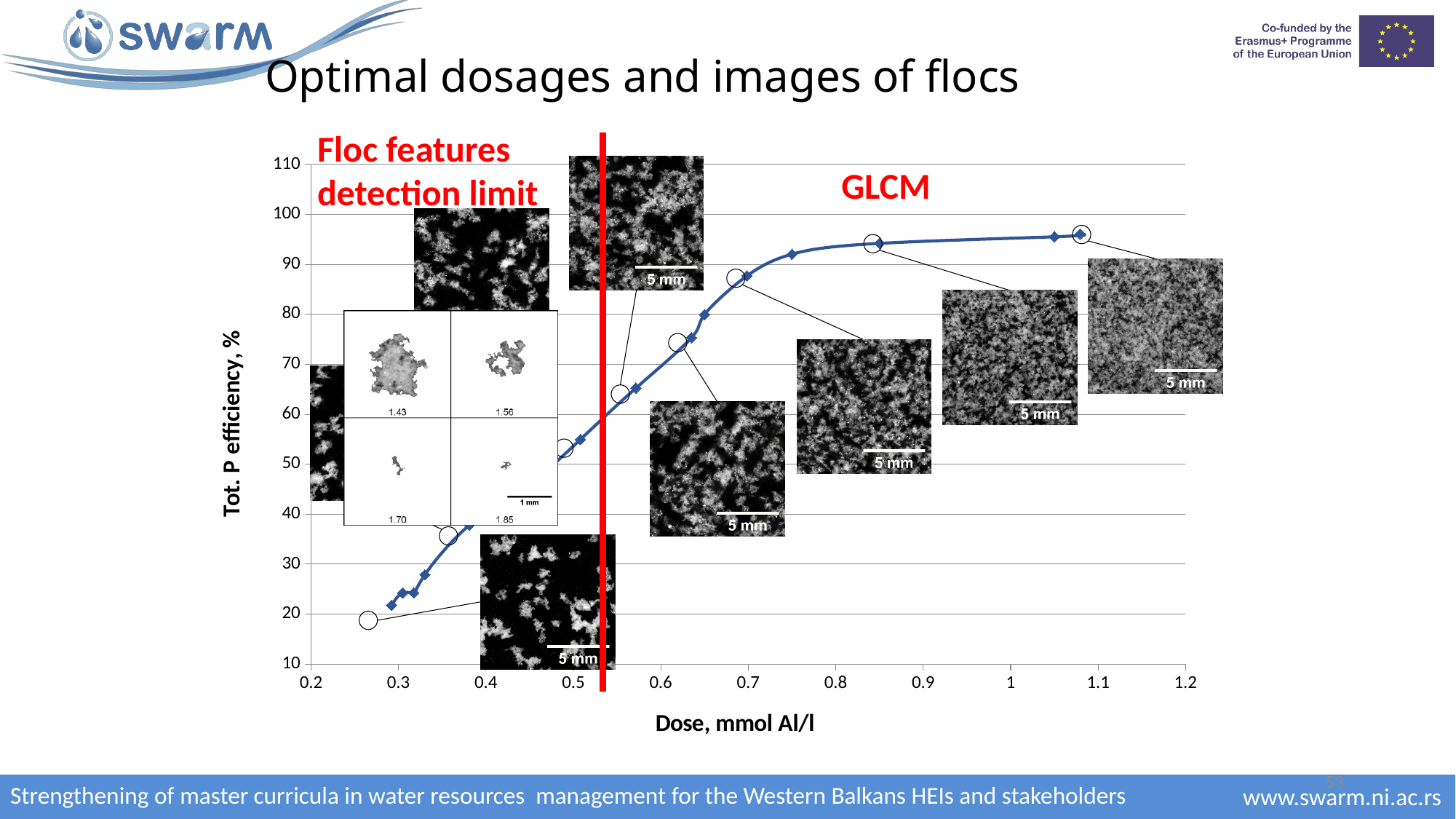
Which is larger: the Tot. P efficiency at a dose of about 0.3 mmol Al/l or at about 0.7 mmol Al/l? 0.7 mmol Al/l Is the Tot. P efficiency at a dose of about 0.85 mmol Al/l greater or less than 100%? less Does Tot. P efficiency rise or fall as the dose increases along the x axis? rise What is the highest value shown on the y axis of the chart? 110 What kind of chart is shown on the slide? line chart Is the Tot. P efficiency at a dose of about 0.7 mmol Al/l greater or less than 80%? greater Is the Tot. P efficiency at a dose of about 1.1 mmol Al/l greater or less than 90%? greater What is the title of the x axis of the chart? Dose, mmol Al/l What is the title of the y axis of the chart? Tot. P efficiency, %